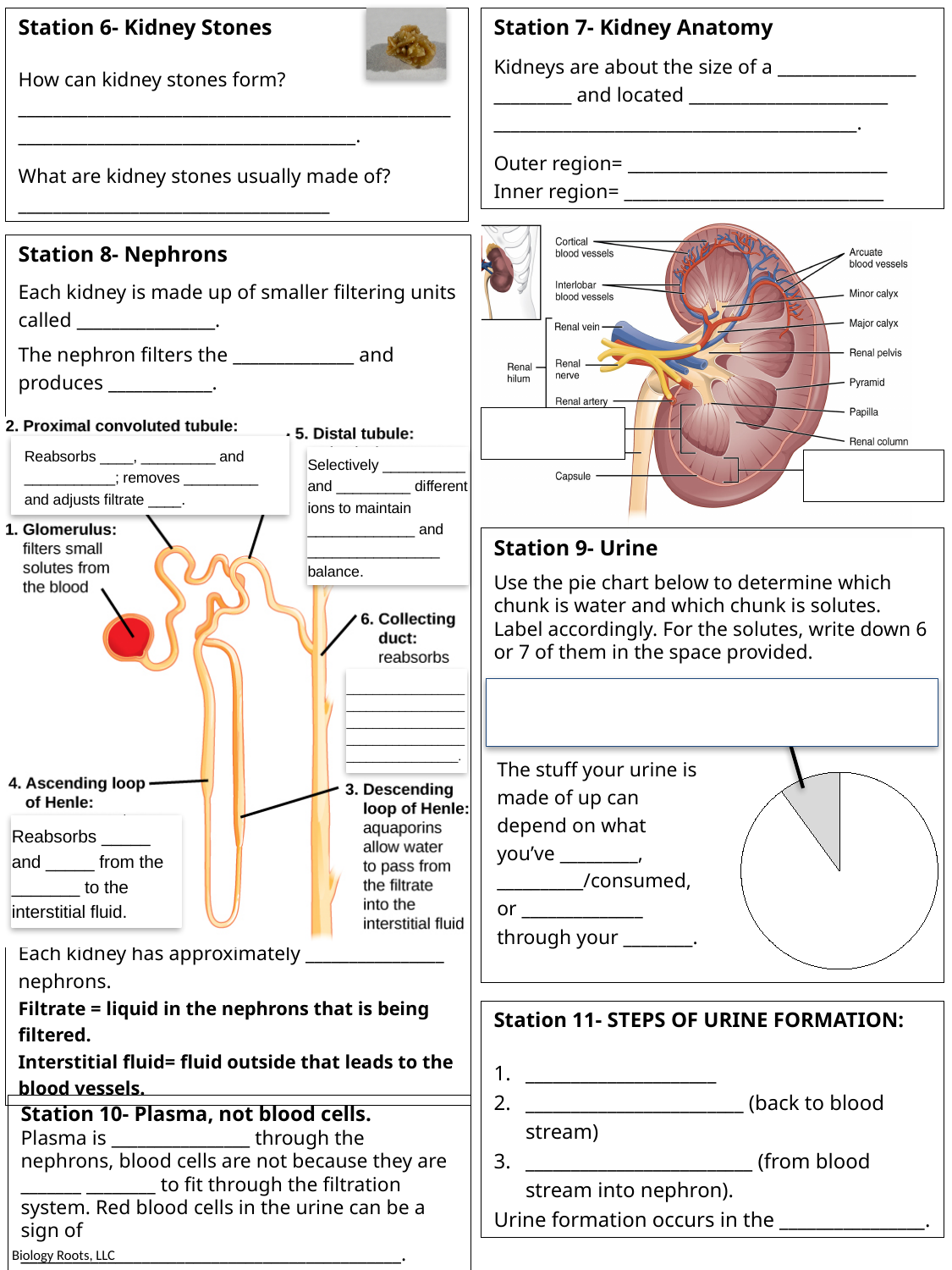
Does the pie chart in Station 9 show any data labels with values? No In the Station 9 pie chart, which slice is larger, the grey slice or the white slice? the white slice In the Station 9 pie chart, which slice is smaller, the grey slice or the white slice? the grey slice How many slices does the pie chart in Station 9 have? 2 Does the pie chart in Station 9 have a legend? No In Station 9, what kind of chart is shown? pie chart